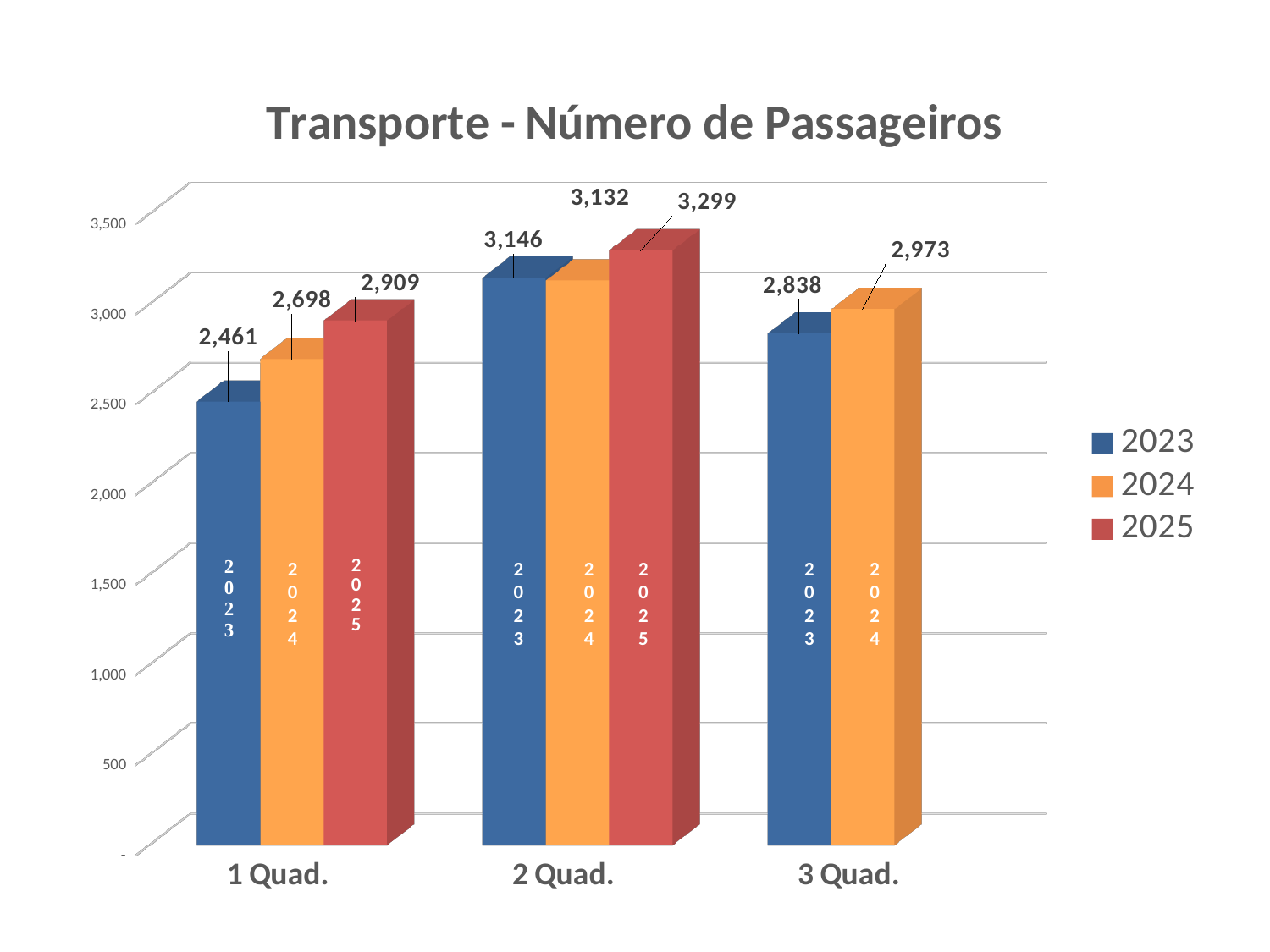
What is the title of the chart? Transporte - Número de Passageiros Is the value for 2023 in 3 Quad. greater or less than 3,000? less Which year has the highest number of passengers in 2 Quad.? 2025 What is the number of passengers for 2023 in 1 Quad.? 2,461 Which is larger in 2 Quad., the 2023 value or the 2024 value? 2023 What kind of chart is shown on the slide? bar chart How many quarter categories are shown on the x axis? 3 How many series does the legend list? 3 Which year has the lowest number of passengers in 1 Quad.? 2023 What is the number of passengers for 2025 in 2 Quad.? 3,299 What is the number of passengers for 2024 in 3 Quad.? 2,973 What is the difference between the 2025 and 2024 values in 1 Quad.? 211